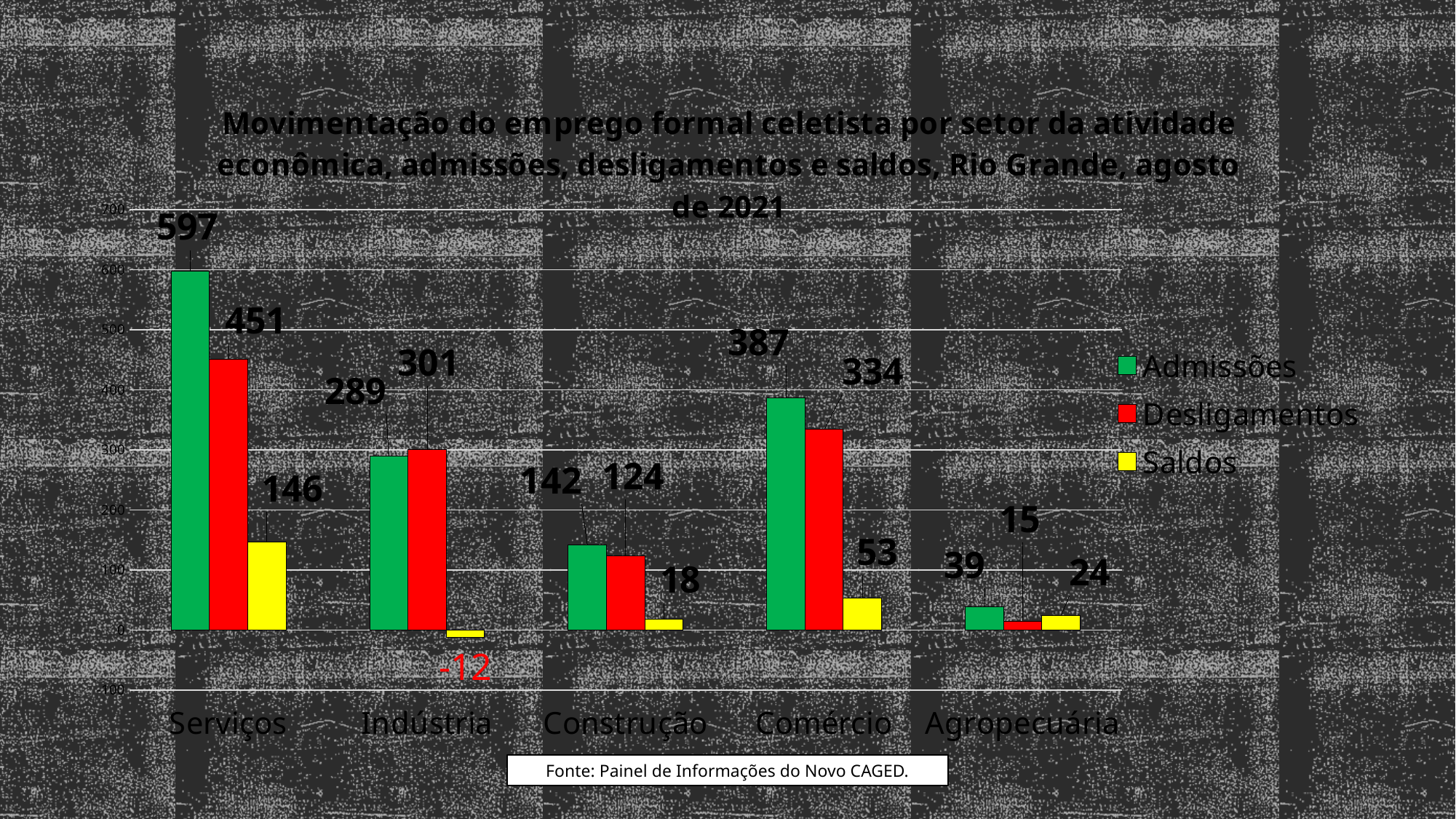
What is the value of Admissões for Serviços? 597 What kind of chart is shown on the slide? Bar chart What is the value of Saldos for Indústria? -12 Which sector has the highest value for Admissões? Serviços Which is larger for Indústria, Admissões or Desligamentos? Desligamentos What is the difference between Admissões and Desligamentos for Serviços? 146 Which sector has the lowest value for Desligamentos? Agropecuária What is the value of Desligamentos for Comércio? 334 How many series does the legend list? 3 What is the value of Saldos for Agropecuária? 24 How many sectors are shown on the x axis? 5 Which colour represents the Saldos series in the legend? Yellow